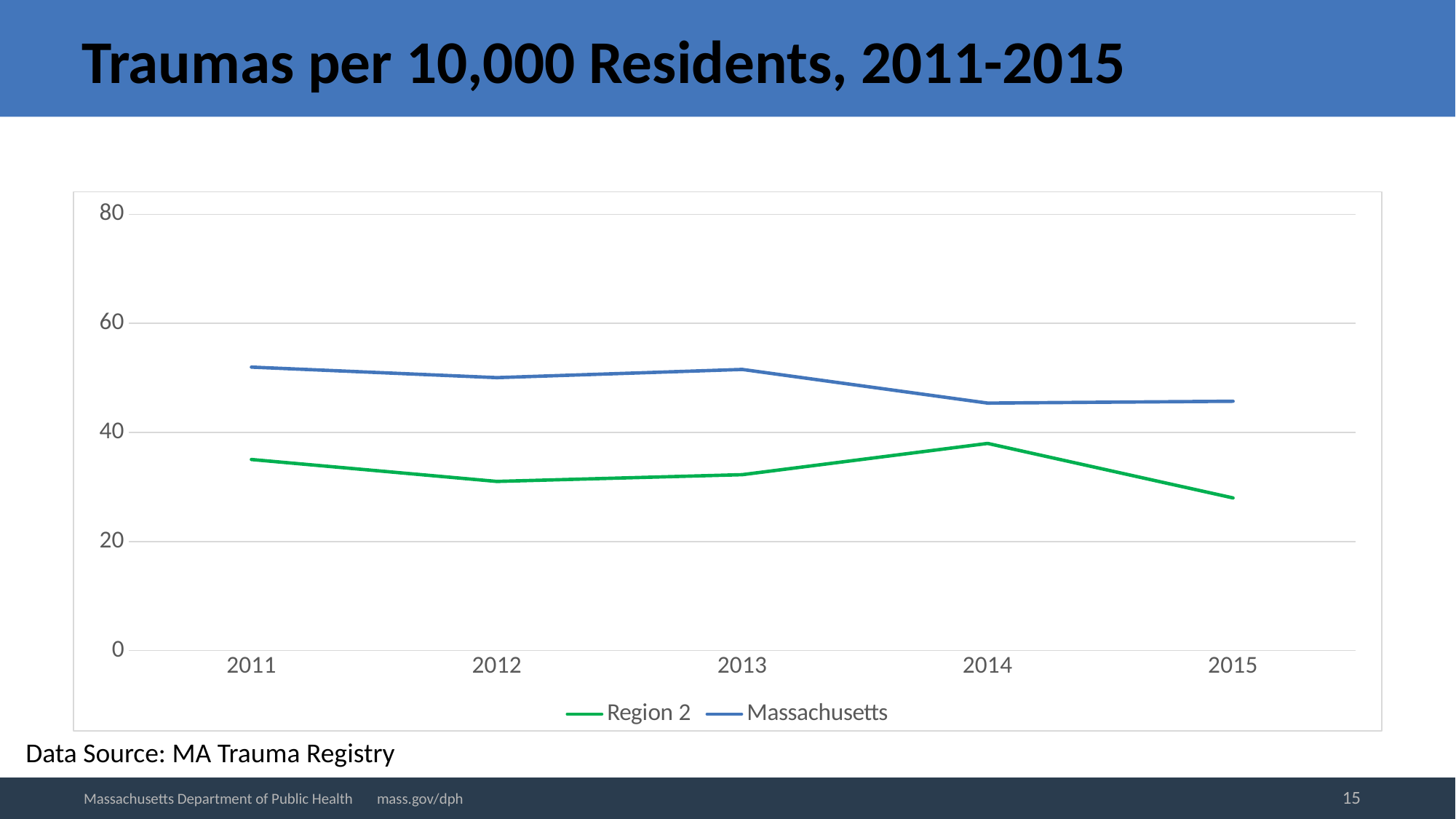
Does the Region 2 value rise or fall from 2014 to 2015? Fall Is the value for Massachusetts in 2011 greater or less than 40? greater Which series is drawn in green? Region 2 How many years are plotted along the x axis? 5 Is the value for Massachusetts in 2014 greater or less than 60? less In which year is the Region 2 value lowest? 2015 How many series does the legend list? 2 In which year is the Region 2 value highest? 2014 What kind of chart is shown on the slide? Line chart Is the value for Region 2 in 2015 greater or less than 40? less What is the title of the chart? Traumas per 10,000 Residents, 2011-2015 In 2013, which series has the larger value, Region 2 or Massachusetts? Massachusetts